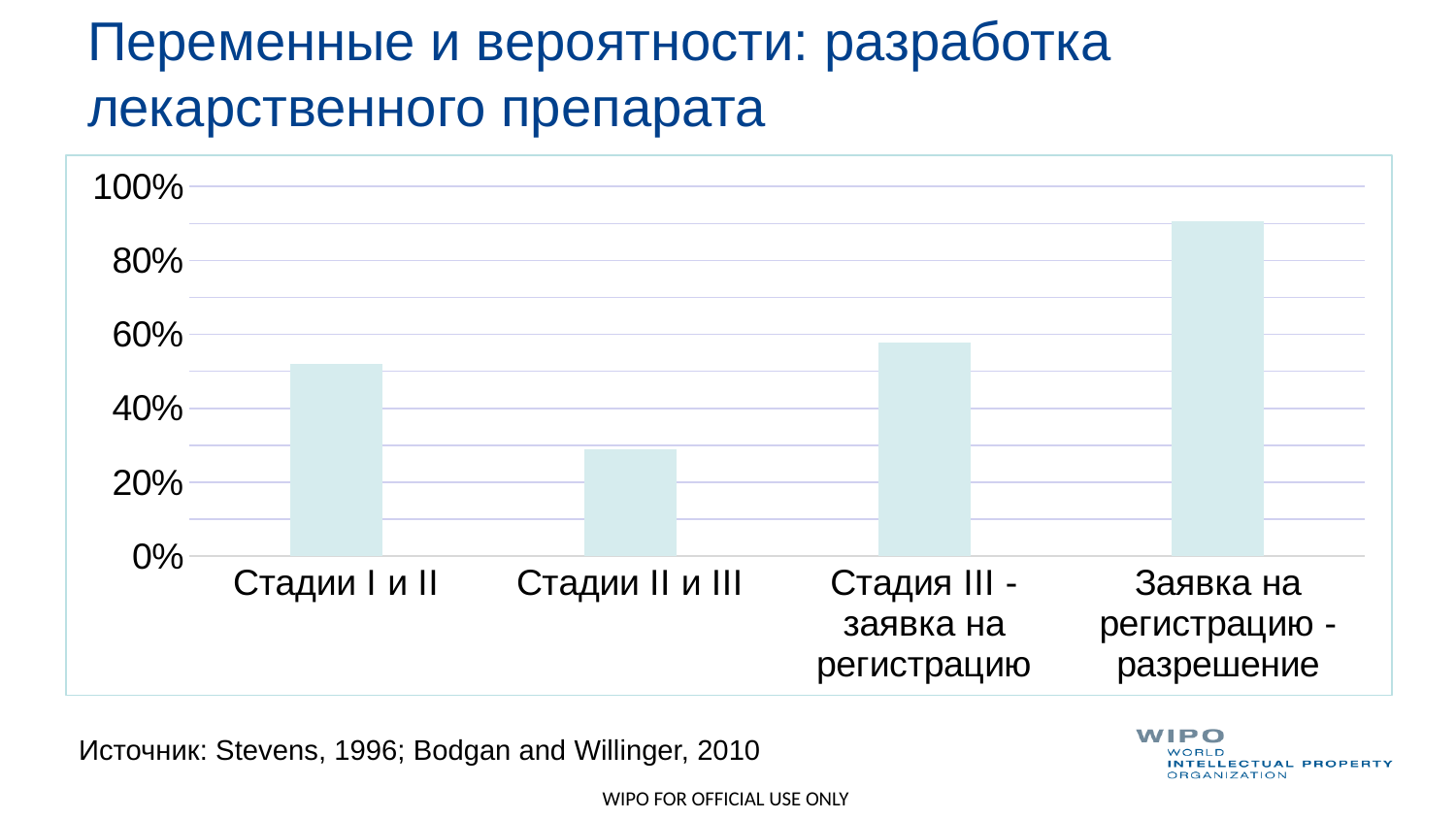
Which category has the highest value in the chart? Заявка на регистрацию - разрешение Which is larger: the value for Стадия III - заявка на регистрацию or the value for Заявка на регистрацию - разрешение? Заявка на регистрацию - разрешение Do the values rise or fall from Стадии II и III to Заявка на регистрацию - разрешение along the x axis? rise Which category has the lowest value in the chart? Стадии II и III Which is larger: the value for Стадии I и II or the value for Стадии II и III? Стадии I и II Is the value for Заявка на регистрацию - разрешение greater or less than 80%? greater Is the value for Стадии II и III greater or less than 40%? less Is the value for Стадии I и II greater or less than 40%? greater What is the title of the slide containing the chart? Переменные и вероятности: разработка лекарственного препарата How many categories are shown on the x axis of the chart? 4 What kind of chart is shown on the slide? bar chart